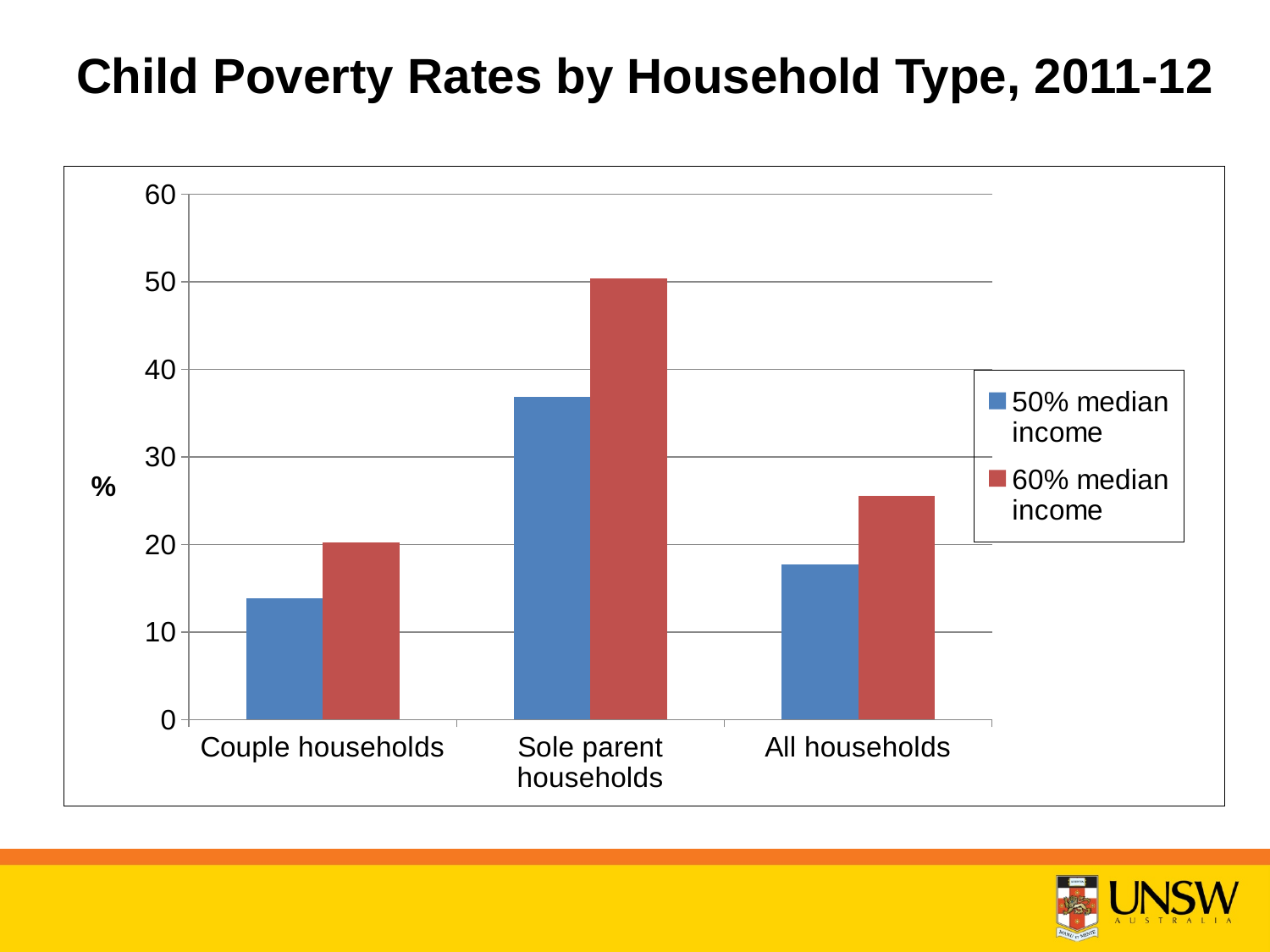
How many household types are shown on the x axis? 3 Which household type has the lowest child poverty rate at 50% median income? Couple households Is the 60% median income value for Sole parent households greater or less than 40? greater Which household type has the highest child poverty rate at 60% median income? Sole parent households What kind of chart is shown on the slide? bar chart What label is shown on the vertical axis? % Is the 60% median income value for All households greater or less than 30? less Is the 50% median income value for Couple households greater or less than 20? less Which is larger: the 50% median income value for Sole parent households or the 60% median income value for All households? Sole parent households at 50% median income What is the title of the chart? Child Poverty Rates by Household Type, 2011-12 How many series does the legend list? 2